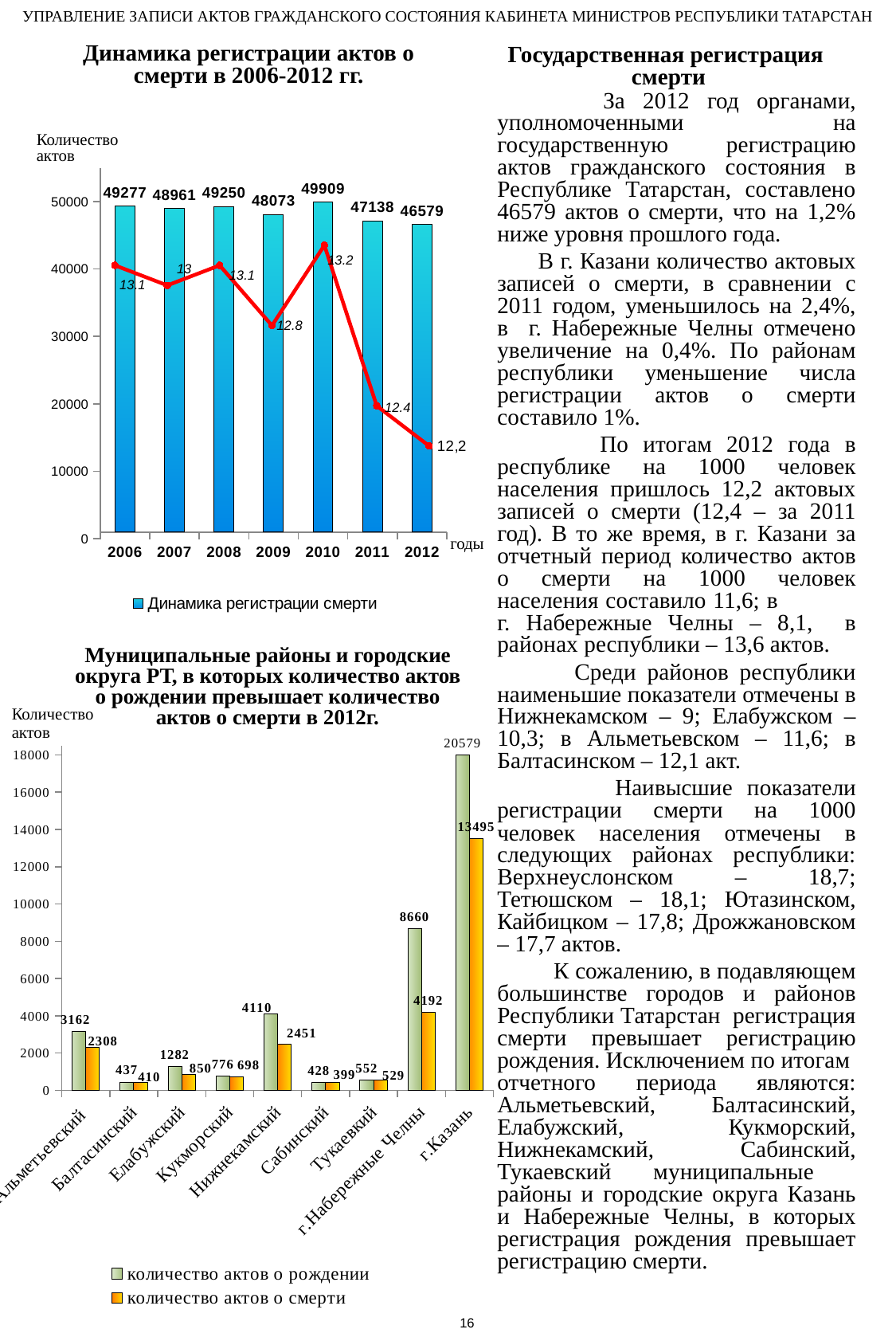
In the chart 'Динамика регистрации актов о смерти в 2006-2012 гг.', what is the difference between the 2011 and 2012 values? 559 In the bottom chart 'Муниципальные районы и городские округа РТ...', how many birth acts were registered in г.Казань? 20579 In the bottom chart 'Муниципальные районы и городские округа РТ...', what is the difference between birth acts and death acts in Нижнекамский? 1659 What kind of chart is the bottom chart 'Муниципальные районы и городские округа РТ...'? bar chart In the chart 'Динамика регистрации актов о смерти в 2006-2012 гг.', how many death acts were registered in 2010? 49909 In the chart 'Динамика регистрации актов о смерти в 2006-2012 гг.', how many years are shown on the x axis? 7 In the bottom chart 'Муниципальные районы и городские округа РТ...', which category has the lowest number of death acts? Сабинский In the chart 'Динамика регистрации актов о смерти в 2006-2012 гг.', which year has the lowest number of death acts? 2012 In the chart 'Динамика регистрации актов о смерти в 2006-2012 гг.', which year has the highest number of death acts? 2010 In the bottom chart 'Муниципальные районы и городские округа РТ...', how many series does the legend list? 2 In the bottom chart 'Муниципальные районы и городские округа РТ...', how many death acts were registered in г.Набережные Челны? 4192 In the chart 'Динамика регистрации актов о смерти в 2006-2012 гг.', what value does the red line show for 2012? 12,2